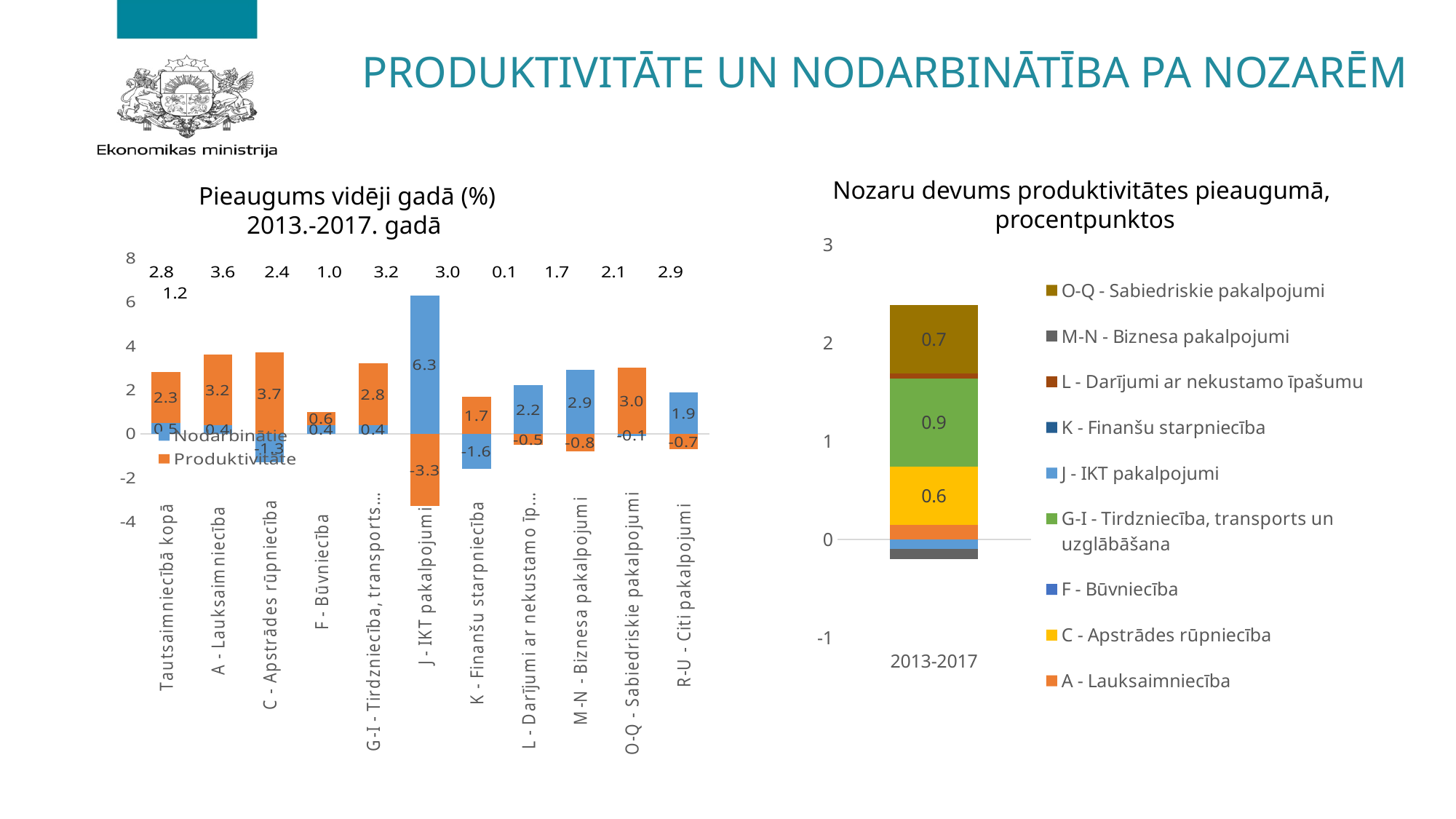
In the left chart 'Pieaugums vidēji gadā (%)', what is the Nodarbinātie value for J - IKT pakalpojumi? 6.3 In the left chart 'Pieaugums vidēji gadā (%)', how many series does the legend list? 2 In the left chart 'Pieaugums vidēji gadā (%)', which category has the highest Produktivitāte value? C - Apstrādes rūpniecība In the left chart 'Pieaugums vidēji gadā (%)', which category has the lowest Produktivitāte value? J - IKT pakalpojumi In the left chart 'Pieaugums vidēji gadā (%)', what is the difference between the Produktivitāte value for A - Lauksaimniecība and for Tautsaimniecībā kopā? 0.9 In the right chart 'Nozaru devums produktivitātes pieaugumā, procentpunktos', what is the value of the G-I - Tirdzniecība, transports un uzglabāšana segment? 0.9 In the left chart 'Pieaugums vidēji gadā (%)', which category has the highest Nodarbinātie value? J - IKT pakalpojumi In the left chart 'Pieaugums vidēji gadā (%)', how many categories are shown on the x axis? 11 In the right chart 'Nozaru devums produktivitātes pieaugumā, procentpunktos', how many entries does the legend list? 9 In the left chart 'Pieaugums vidēji gadā (%)', which has the larger Nodarbinātie value: M-N - Biznesa pakalpojumi or L - Darījumi ar nekustamo īp...? M-N - Biznesa pakalpojumi What kind of chart is the left chart titled 'Pieaugums vidēji gadā (%) 2013.-2017. gadā'? bar chart In the left chart 'Pieaugums vidēji gadā (%)', what is the Produktivitāte value for C - Apstrādes rūpniecība? 3.7